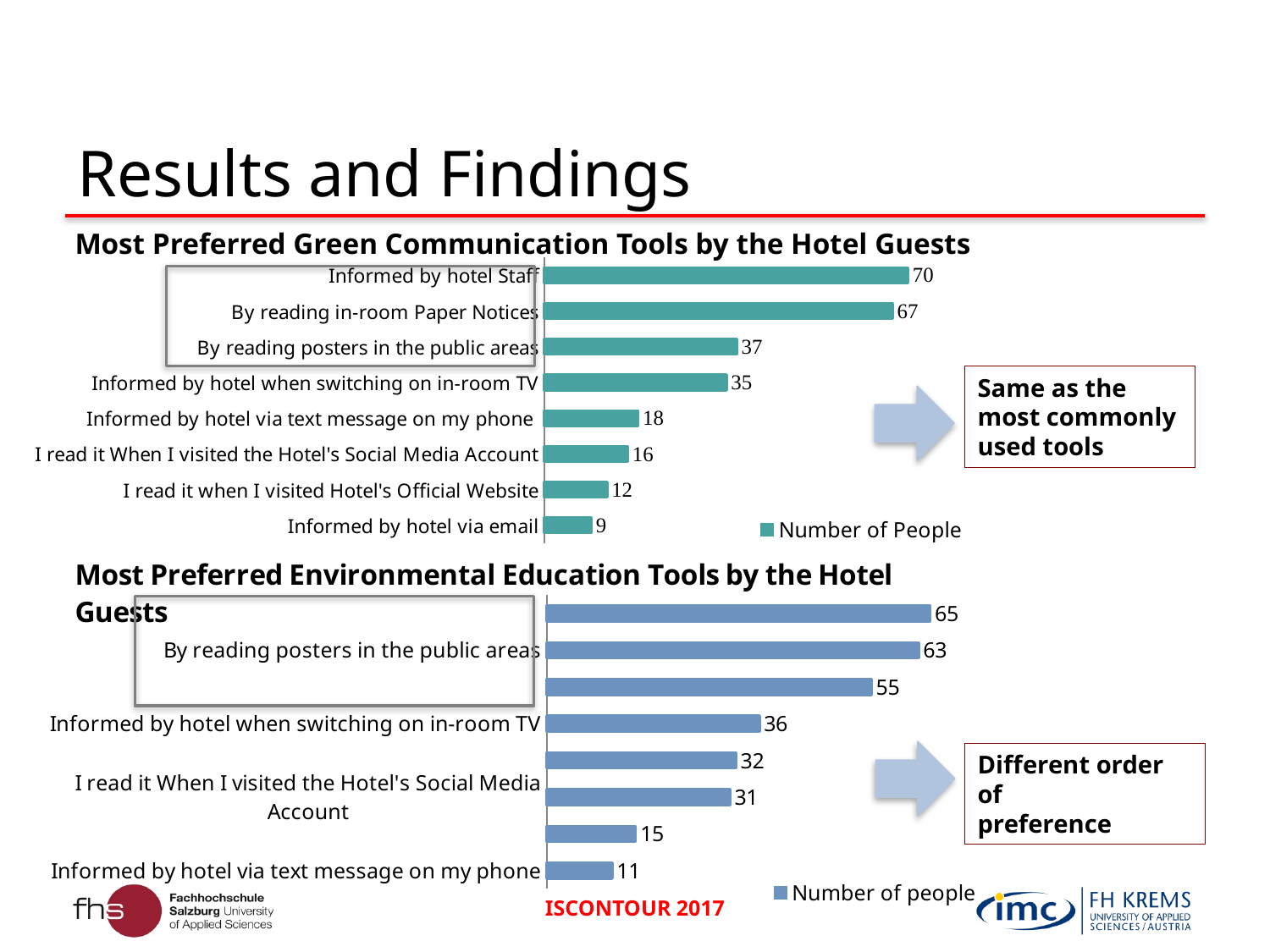
In the 'Most Preferred Green Communication Tools by the Hotel Guests' chart, what is the value for 'Informed by hotel Staff'? 70 In the 'Most Preferred Green Communication Tools by the Hotel Guests' chart, which category has the lowest value? Informed by hotel via email In the 'Most Preferred Green Communication Tools by the Hotel Guests' chart, which category has the highest value? Informed by hotel Staff What type of chart is the 'Most Preferred Environmental Education Tools by the Hotel Guests' chart? Bar chart In the 'Most Preferred Environmental Education Tools by the Hotel Guests' chart, what is the value for 'Informed by hotel via text message on my phone'? 11 In the 'Most Preferred Green Communication Tools by the Hotel Guests' chart, which is larger: 'Informed by hotel via text message on my phone' or 'I read it when I visited Hotel's Official Website'? Informed by hotel via text message on my phone What is the legend entry in the 'Most Preferred Green Communication Tools by the Hotel Guests' chart? Number of People In the 'Most Preferred Green Communication Tools by the Hotel Guests' chart, how many categories are shown? 8 In the 'Most Preferred Environmental Education Tools by the Hotel Guests' chart, what is the value for 'Informed by hotel when switching on in-room TV'? 36 In the 'Most Preferred Green Communication Tools by the Hotel Guests' chart, what is the difference between 'By reading posters in the public areas' and 'Informed by hotel when switching on in-room TV'? 2 In the 'Most Preferred Environmental Education Tools by the Hotel Guests' chart, what is the value for 'By reading posters in the public areas'? 63 In the 'Most Preferred Green Communication Tools by the Hotel Guests' chart, what is the value for 'By reading in-room Paper Notices'? 67